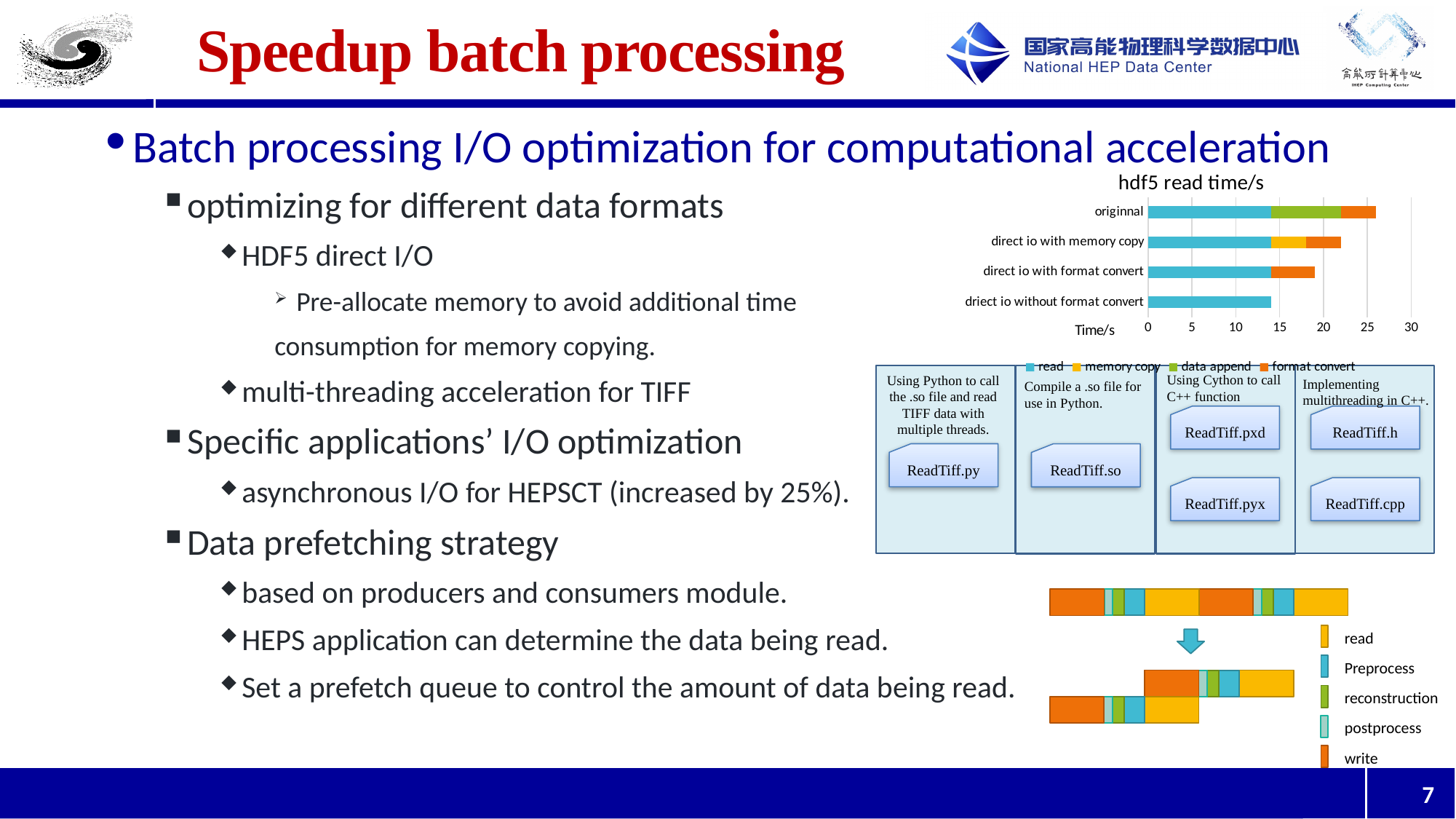
In the 'hdf5 read time/s' chart, is the total value for 'originnal' greater or less than 20? greater In the 'hdf5 read time/s' chart, what is the label of the horizontal axis? Time/s In the 'hdf5 read time/s' chart, which has the larger total: 'originnal' or 'direct io with memory copy'? originnal What is the title of the bar chart on the slide? hdf5 read time/s How many series does the legend of the 'hdf5 read time/s' chart list? 4 In the 'hdf5 read time/s' chart, is the total value for 'driect io without format convert' greater or less than 15? less How many categories (bars) does the 'hdf5 read time/s' chart show? 4 In the 'hdf5 read time/s' chart, which category has the longest total bar? originnal In the 'hdf5 read time/s' chart, is the total value for 'direct io with format convert' greater or less than 15? greater In the 'hdf5 read time/s' chart, which category has the shortest total bar? driect io without format convert In the 'hdf5 read time/s' chart, which category's bar consists of only the 'read' segment? driect io without format convert What kind of chart is the 'hdf5 read time/s' chart? bar chart